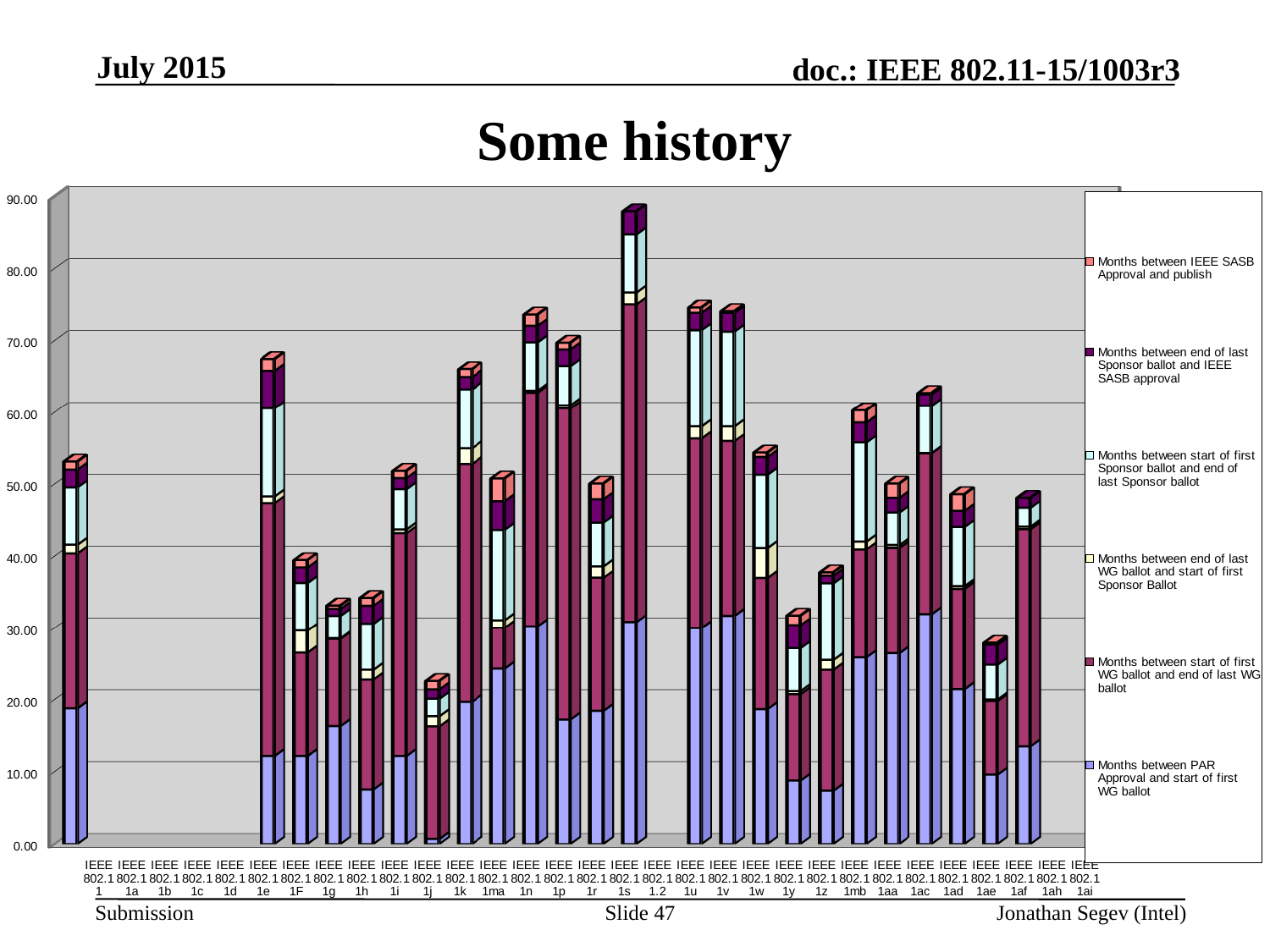
Which has the taller stacked bar, IEEE 802.11s or IEEE 802.11n? IEEE 802.11s How many categories are shown along the x axis? 31 Is the total for IEEE 802.11s greater or less than 80? greater Which category has the tallest stacked bar? IEEE 802.11s How many series does the legend list? 6 Which legend entry corresponds to the bottom segment of each stacked bar? Months between PAR Approval and start of first WG ballot Which has the taller stacked bar, IEEE 802.11e or IEEE 802.11g? IEEE 802.11e What is the title of the chart? Some history Is the total for IEEE 802.11g greater or less than 40? less Is the total for IEEE 802.11e greater or less than 60? greater What kind of chart is shown on the slide? Stacked bar chart